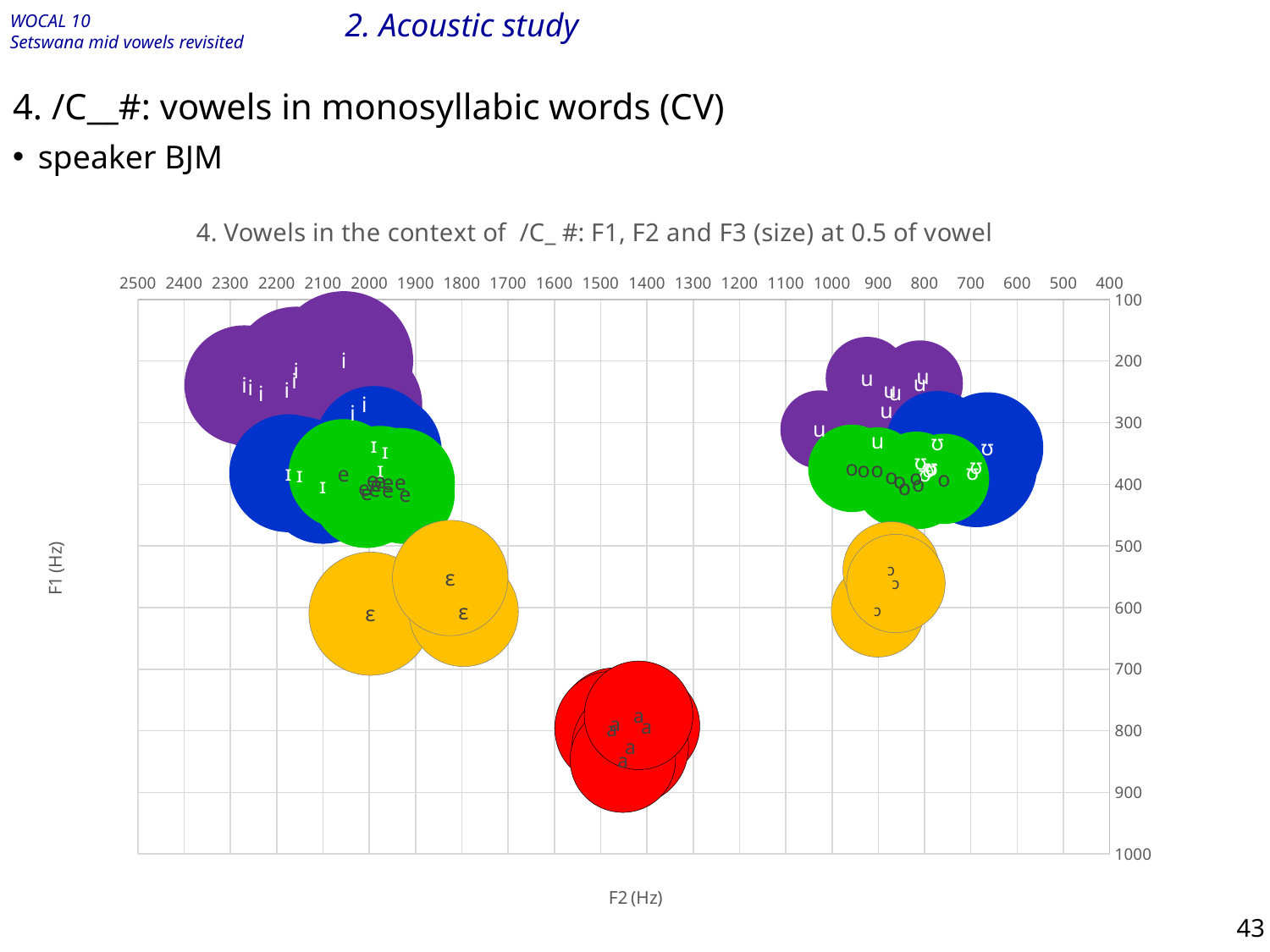
Is the F2 value for the vowel /u/ greater or less than 1500? less What is the title of the chart? 4. Vowels in the context of /C_ #: F1, F2 and F3 (size) at 0.5 of vowel Is the F1 value for the vowel /ɔ/ greater or less than 500? greater Which vowel has the highest F2 value in the chart? /i/ How many different vowel categories are plotted in the chart? 9 Which vowel has the highest F1 value in the chart? /a/ What kind of chart is shown on the slide? bubble chart Which has the larger F1 value, the vowel /a/ or the vowel /i/? /a/ Is the F2 value for the vowel /a/ greater or less than 2000? less What is the label of the horizontal axis of the chart? F2 (Hz)